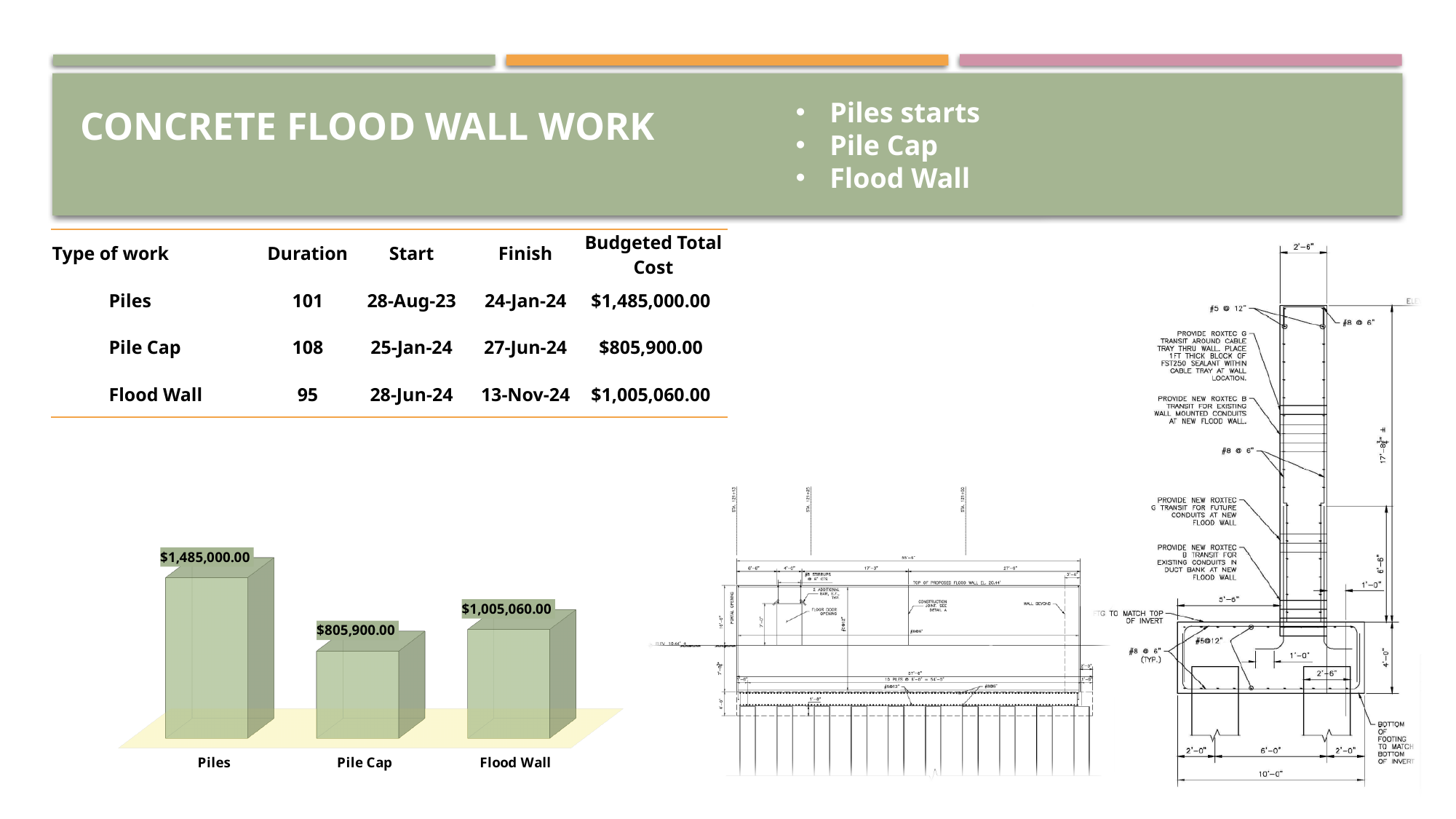
What is the difference between the values for Piles and Pile Cap in the bar chart? $679,100.00 What is the value shown for Pile Cap in the bar chart? $805,900.00 How many categories are shown in the bar chart? 3 What is the difference between the values for Flood Wall and Pile Cap in the bar chart? $199,160.00 What is the value shown for Flood Wall in the bar chart? $1,005,060.00 What kind of chart is shown on the slide? Bar chart What is the total of the three values shown in the bar chart? $3,295,960.00 What is the value shown for Piles in the bar chart? $1,485,000.00 Which is larger in the bar chart, the value for Flood Wall or the value for Pile Cap? Flood Wall Which category has the highest value in the bar chart? Piles Which is larger in the bar chart, the value for Piles or the value for Flood Wall? Piles Which category has the lowest value in the bar chart? Pile Cap